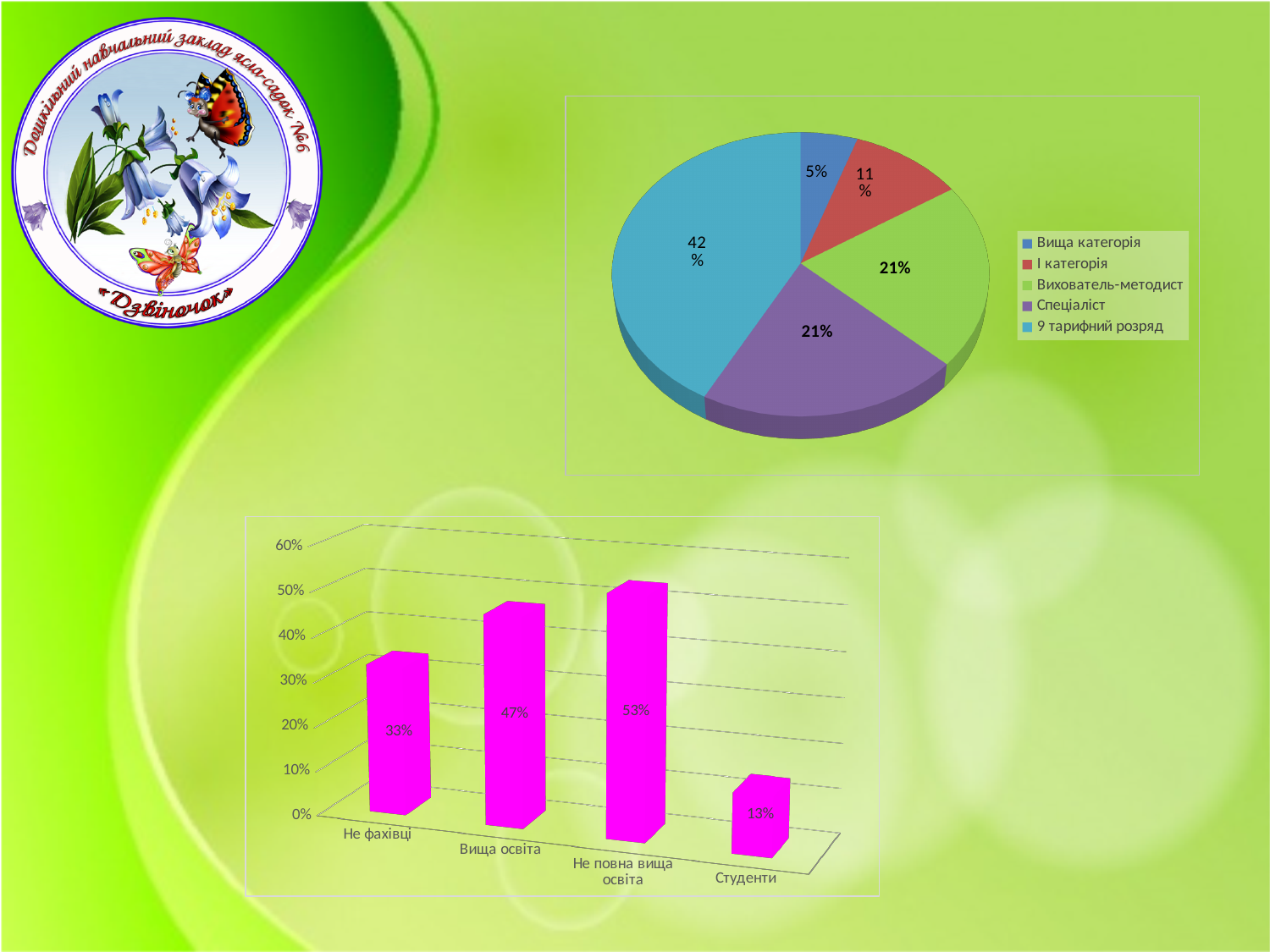
In the pie chart at the top right of the slide, what share does the slice for Вища категорія have? 5% In the bar chart at the bottom of the slide, what is the difference between the values for Не повна вища освіта and Студенти? 40% In the pie chart at the top right of the slide, what is the difference between the shares for 9 тарифний розряд and І категорія? 31% In the pie chart at the top right of the slide, what share does the slice for 9 тарифний розряд have? 42% In the pie chart at the top right of the slide, how many categories does the legend list? 5 In the pie chart at the top right of the slide, which category has the largest slice? 9 тарифний розряд What kind of chart is shown at the bottom of the slide? Bar chart In the bar chart at the bottom of the slide, which is larger: the value for Не фахівці or the value for Вища освіта? Вища освіта In the pie chart at the top right of the slide, which category has the smallest slice? Вища категорія In the bar chart at the bottom of the slide, what is the value for Вища освіта? 47% In the bar chart at the bottom of the slide, which category has the lowest value? Студенти In the bar chart at the bottom of the slide, which category has the highest value? Не повна вища освіта